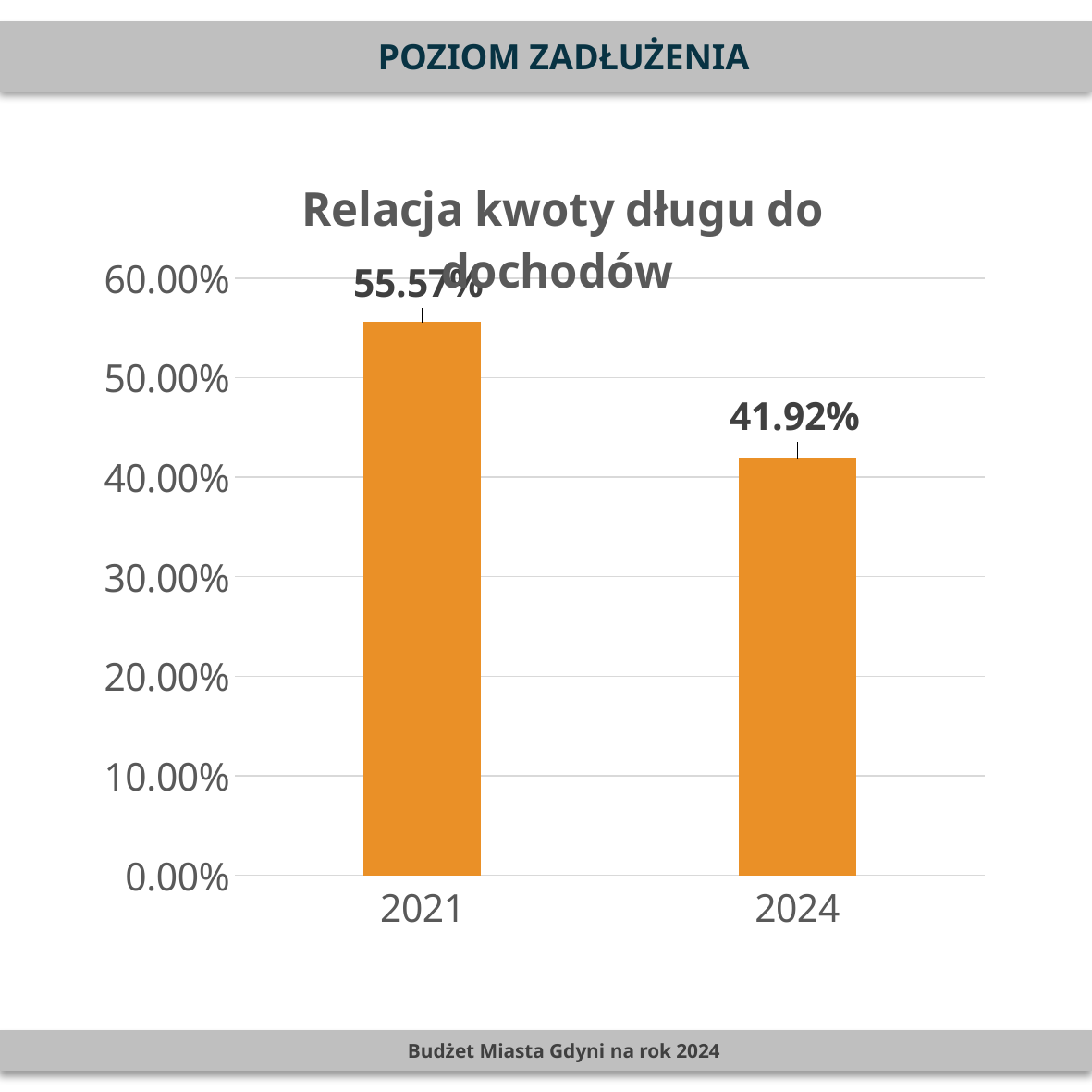
Which year has the highest value? 2021 How many categories are shown on the x axis? 2 What kind of chart is this? bar chart Do the values rise or fall from 2021 to 2024? fall Which is larger, the value for 2021 or the value for 2024? 2021 Is the value for 2021 greater or less than 50.00%? greater Which year has the lowest value? 2024 What is the difference between the values for 2021 and 2024? 13.65% What is the value for 2021? 55.57% Is the value for 2024 greater or less than 50.00%? less What is the value for 2024? 41.92% What is the title of the chart? Relacja kwoty długu do dochodów